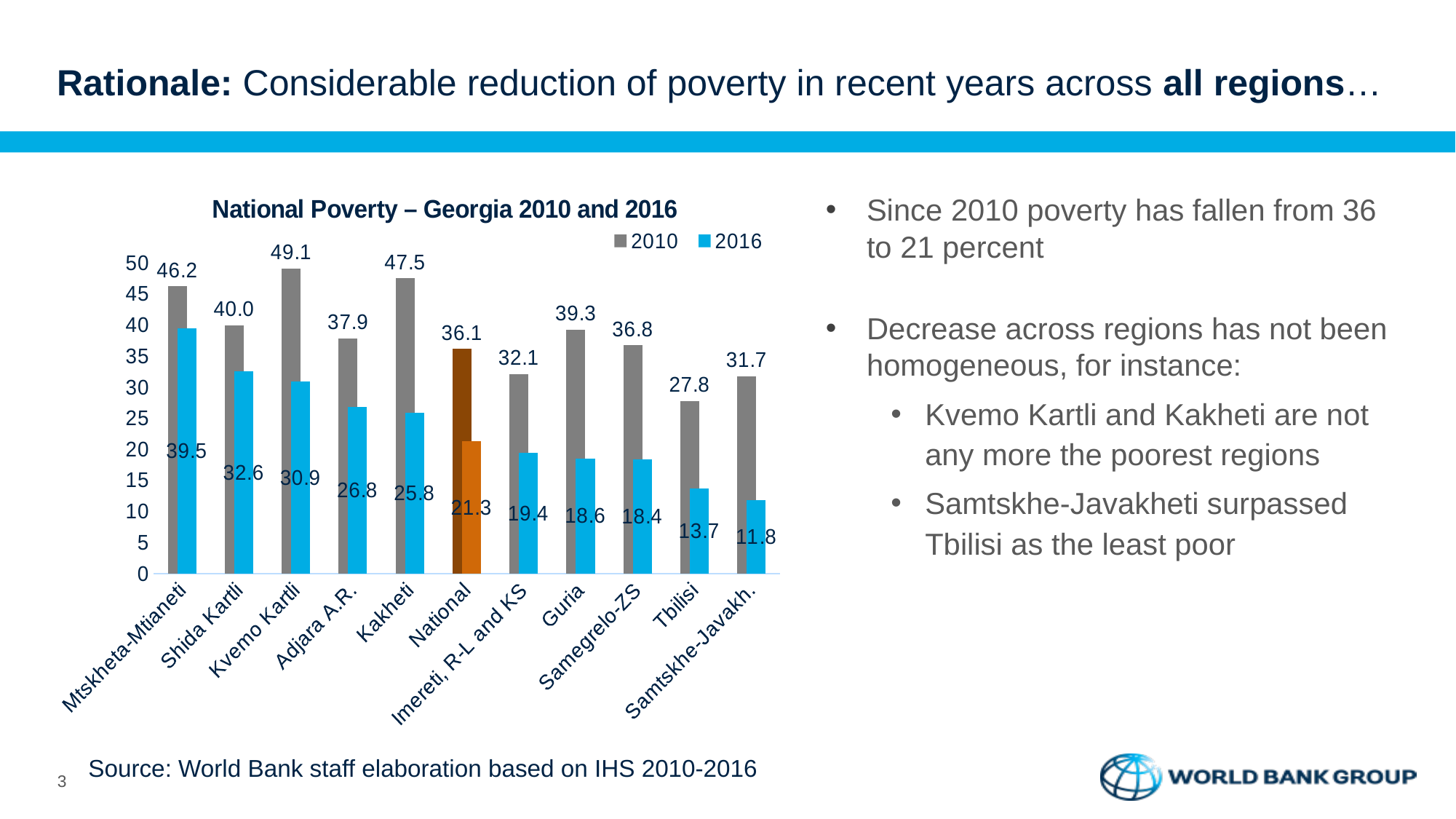
What is the title of the chart? National Poverty – Georgia 2010 and 2016 How many series does the legend list? 2 By how much did the poverty rate in Kakheti fall between 2010 and 2016? 21.7 What kind of chart is shown on the slide? bar chart What was the 2010 poverty rate for Kvemo Kartli? 49.1 Which category has the highest 2010 value? Kvemo Kartli How many categories are shown on the x axis? 11 Which is larger: the 2016 value for Guria or the 2016 value for Samegrelo-ZS? Guria Is the 2010 value for Tbilisi greater or less than 30? less What is the National poverty value for 2016? 21.3 What was the 2016 poverty rate for Tbilisi? 13.7 Which category has the lowest 2016 value? Samtskhe-Javakh.